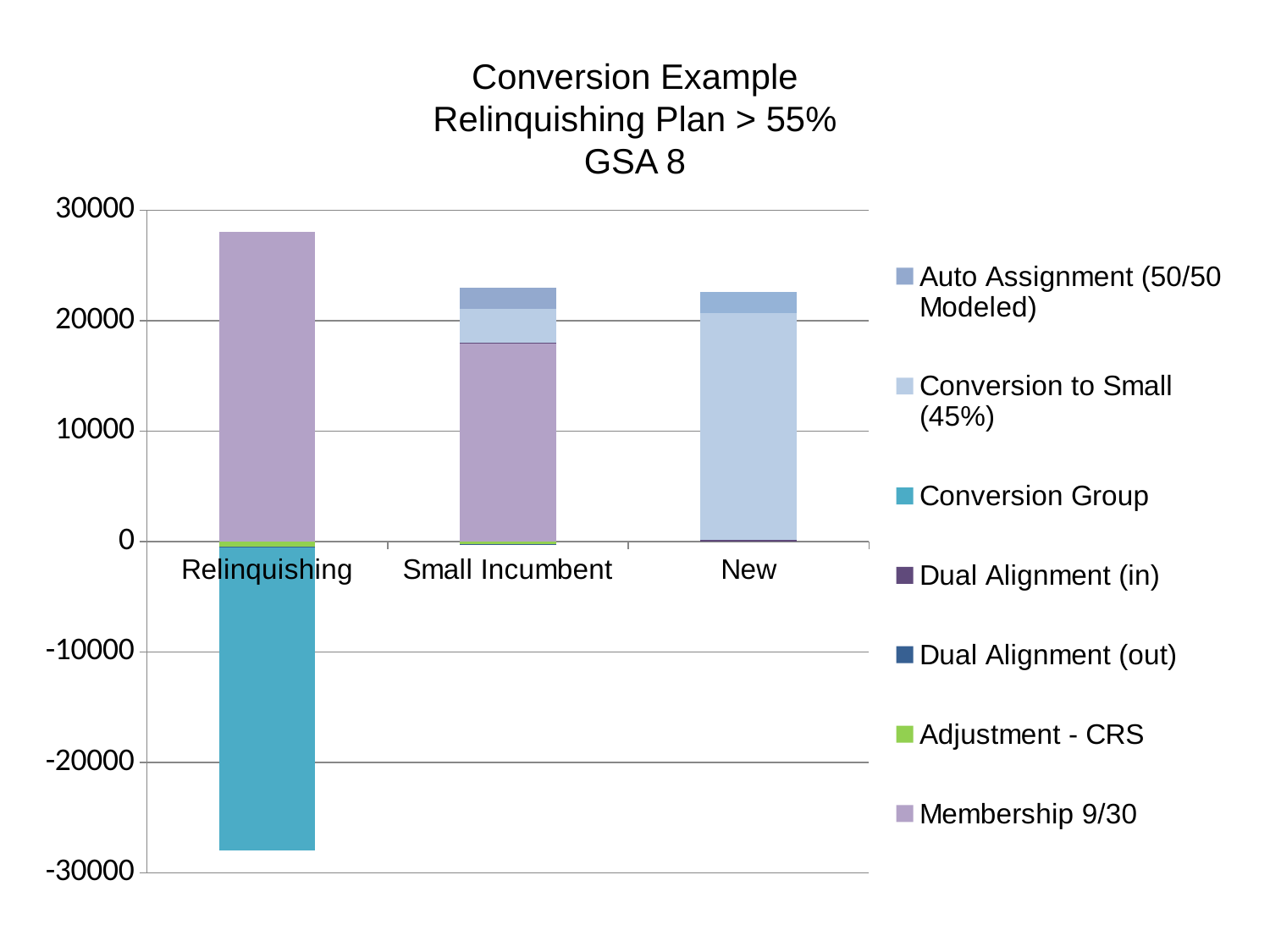
Is the Conversion Group value for Relinquishing greater or less than -20000? less Which category is the only one with a large negative bar segment? Relinquishing Which series is shown in the teal colour in the legend? Conversion Group Is the Membership 9/30 value for Small Incumbent greater or less than 20000? less What kind of chart is shown on the slide? Stacked bar chart Which category has the largest Membership 9/30 value? Relinquishing Which is larger, the Membership 9/30 value for Relinquishing or for Small Incumbent? Relinquishing Is the Membership 9/30 value for Relinquishing greater or less than 20000? greater What is the title of the chart? Conversion Example Relinquishing Plan > 55% GSA 8 How many categories are shown on the x axis? 3 How many series does the legend list? 7